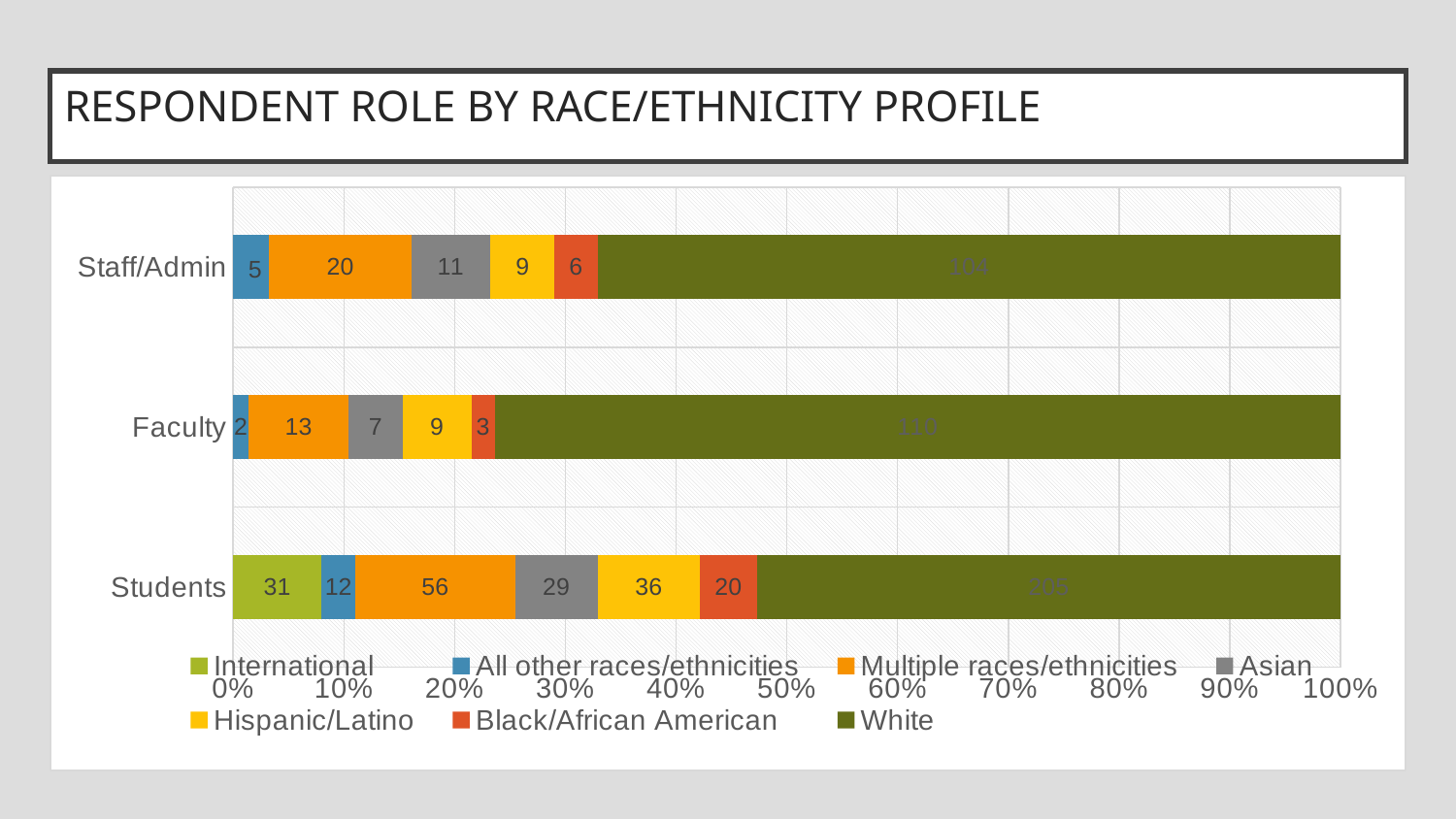
How many respondent roles are shown on the chart? 3 What is the value for Hispanic/Latino in the Staff/Admin bar? 9 What kind of chart is shown on the slide? Stacked bar chart What is the value for Black/African American in the Students bar? 20 What is the value for White in the Faculty bar? 110 Is the White share of the Staff/Admin bar greater or less than 60%? greater Which respondent role has the highest value for Multiple races/ethnicities? Students Which is larger, the Asian value for Staff/Admin or for Faculty? Staff/Admin What is the value for Asian in the Faculty bar? 7 What is the value for Multiple races/ethnicities in the Students bar? 56 How many series does the legend list? 7 What is the difference between the Hispanic/Latino value for Students and for Staff/Admin? 27